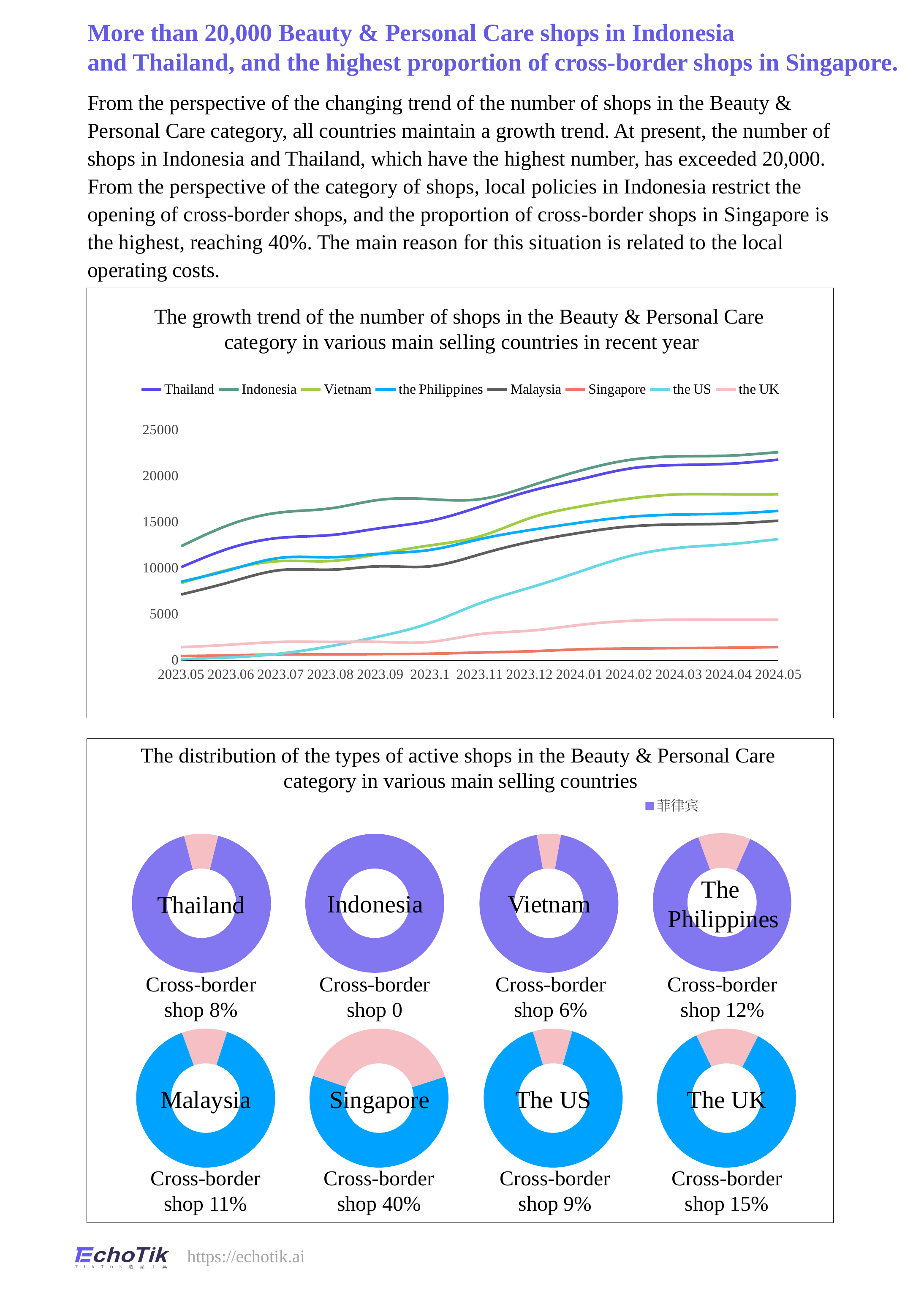
What type of chart is the top chart titled 'The growth trend of the number of shops in the Beauty & Personal Care category in various main selling countries in recent year'? line chart In the top line chart, how many series does the legend list? 8 In the top line chart, is the value for Indonesia at 2024.05 greater or less than 20000? greater In the top line chart, is the value for Singapore at 2024.05 greater or less than 5000? less In the bottom chart showing the distribution of the types of active shops, what is the difference between the cross-border shop share of Singapore and the UK? 25% In the top line chart, which series has the lowest value at 2024.05? Singapore In the top line chart, how many time points are shown on the x axis? 13 In the bottom chart showing the distribution of the types of active shops, which country has the highest cross-border shop share? Singapore In the bottom chart showing the distribution of the types of active shops, how many donut charts are shown? 8 In the top line chart, does the value for the US rise or fall from 2023.05 to 2024.05? rise In the bottom chart showing the distribution of the types of active shops, what is the cross-border shop share for Singapore? 40% In the top line chart, is the value for Malaysia at 2023.05 greater or less than 10000? less